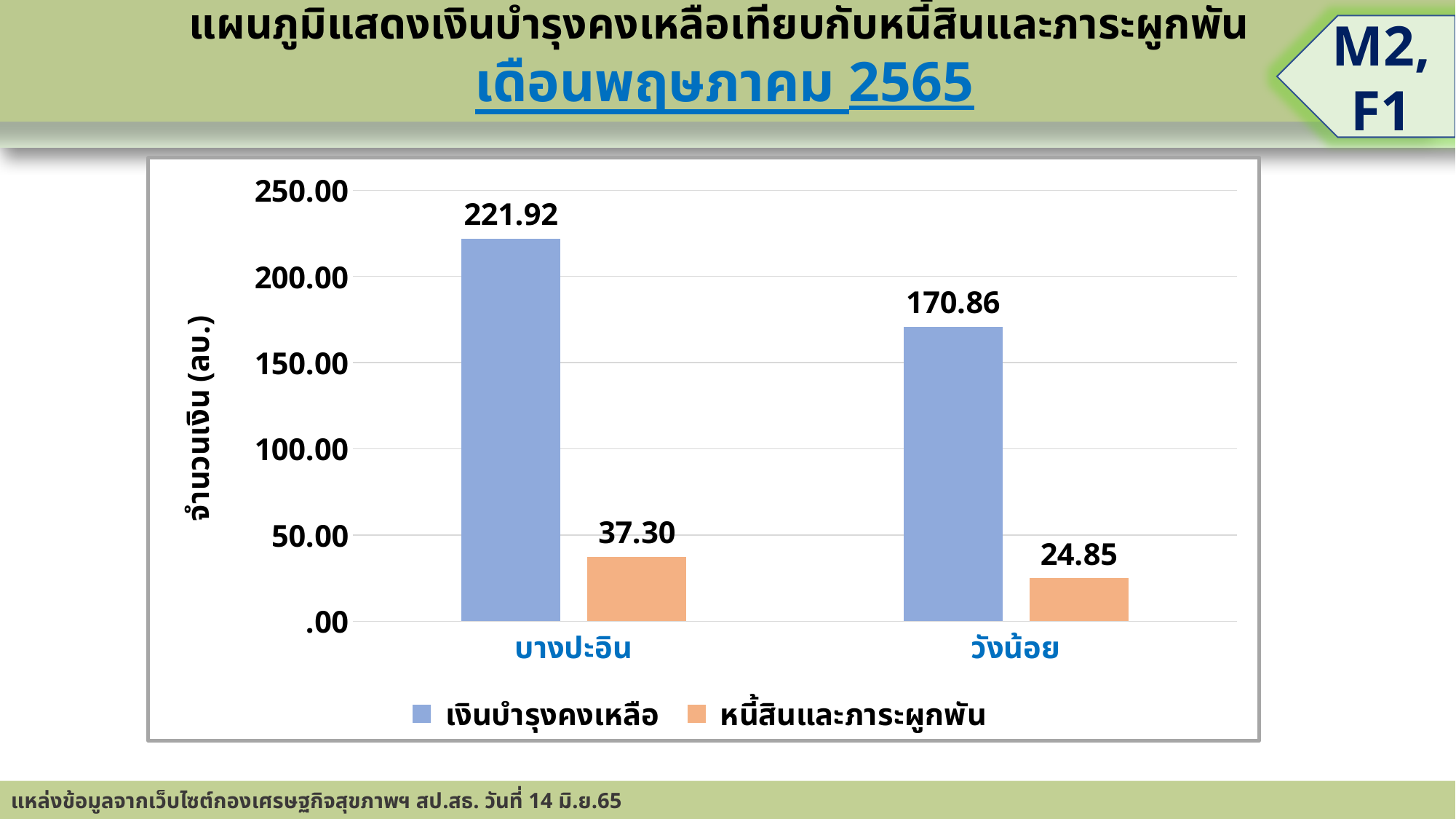
What is the value of เงินบำรุงคงเหลือ for บางปะอิน? 221.92 What is the value of หนี้สินและภาระผูกพัน for วังน้อย? 24.85 How many categories are shown on the x axis? 2 What is the difference between เงินบำรุงคงเหลือ and หนี้สินและภาระผูกพัน for วังน้อย? 146.01 Which category has the highest เงินบำรุงคงเหลือ value? บางปะอิน What kind of chart is shown on the slide? Bar chart Which category has the lowest หนี้สินและภาระผูกพัน value? วังน้อย How many series does the legend list? 2 What is the value of เงินบำรุงคงเหลือ for วังน้อย? 170.86 What is the value of หนี้สินและภาระผูกพัน for บางปะอิน? 37.30 What is the difference between the เงินบำรุงคงเหลือ values for บางปะอิน and วังน้อย? 51.06 Which is larger for บางปะอิน: เงินบำรุงคงเหลือ or หนี้สินและภาระผูกพัน? เงินบำรุงคงเหลือ